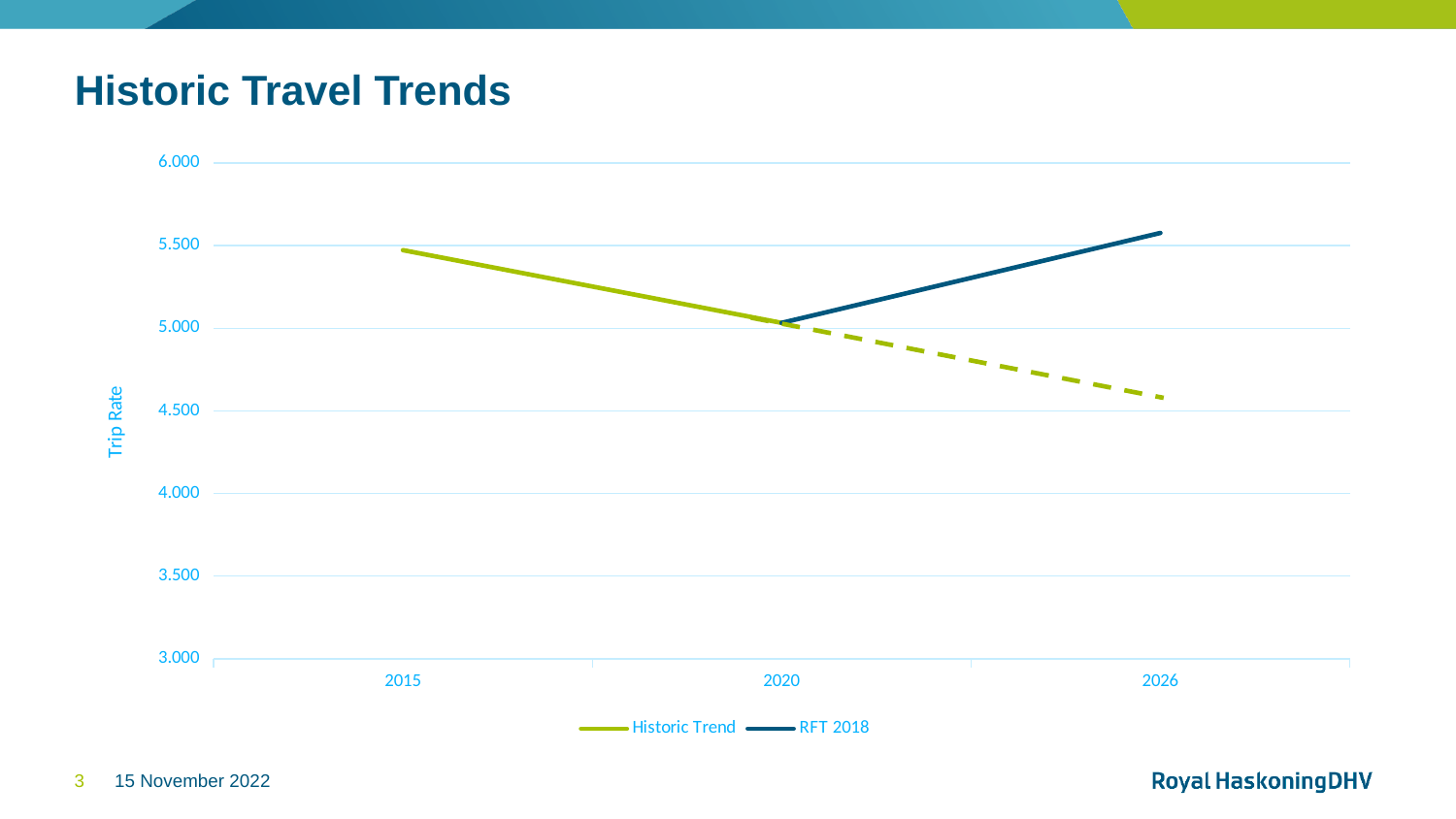
What is the title of the chart on the slide? Historic Travel Trends Does the RFT 2018 line rise or fall from 2020 to 2026? Rise In 2026, which series has the higher value, Historic Trend or RFT 2018? RFT 2018 What is the label on the y axis? Trip Rate How many series does the legend list? 2 Is the RFT 2018 value for 2026 greater or less than 5.000? greater What are the names of the two series in the legend? Historic Trend and RFT 2018 Does the Historic Trend line rise or fall from 2015 to 2026? Fall What kind of chart is shown on the slide? Line chart How many years are labelled on the x axis? 3 Is the Historic Trend value for 2026 greater or less than 5.000? less Is the Historic Trend value for 2015 greater or less than 5.000? greater